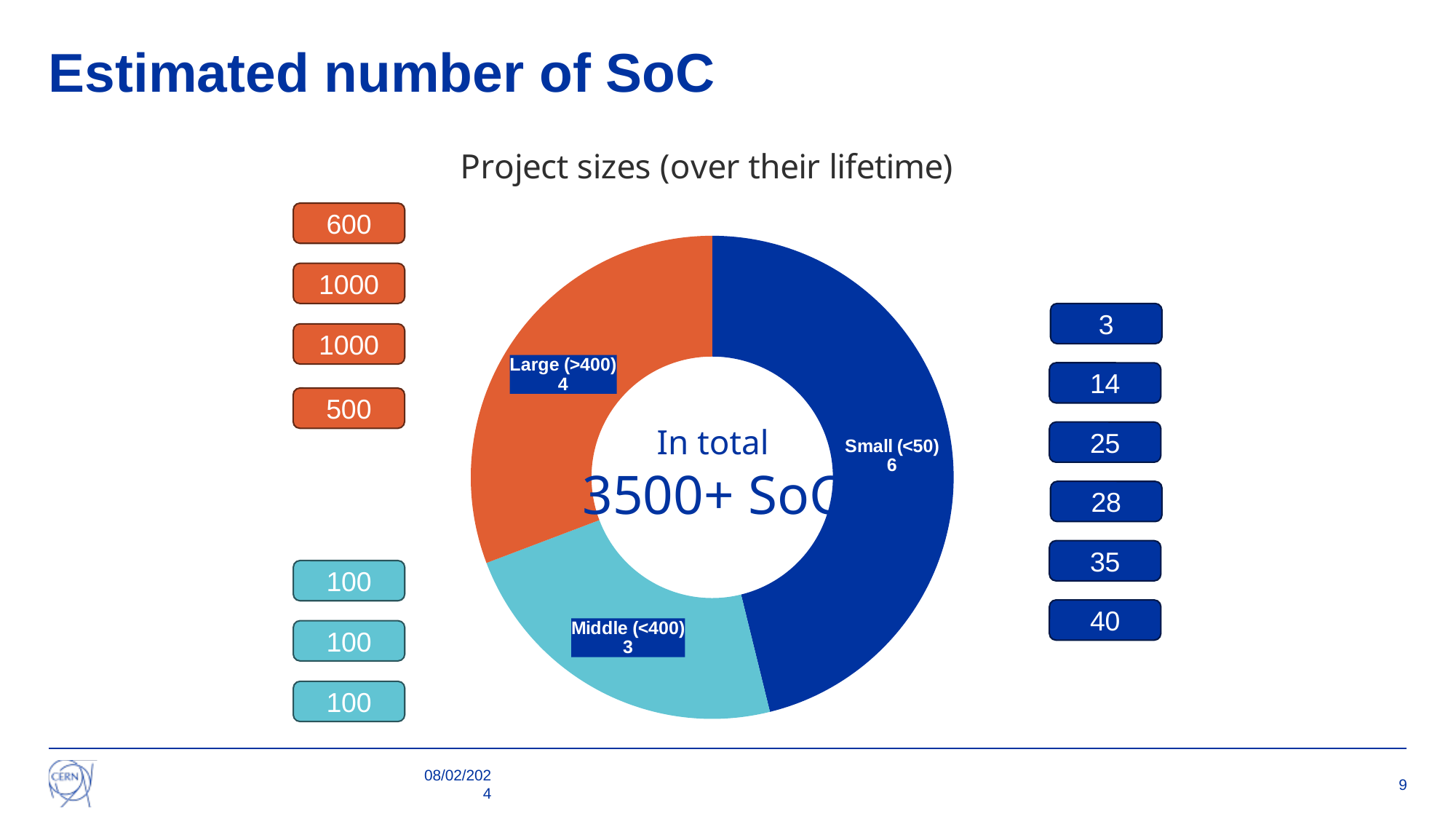
How many slices does the pie chart have? 3 What is the value shown for the Middle (<400) slice? 3 Which project size category has the smallest slice? Middle (<400) What is the title of the chart? Project sizes (over their lifetime) Which is larger, the value for Large (>400) or the value for Small (<50)? Small (<50) What total number of SoC is stated in the centre of the doughnut chart? 3500+ SoC What is the difference between the values for Small (<50) and Middle (<400)? 3 What is the difference between the values for Large (>400) and Middle (<400)? 1 What is the value shown for the Large (>400) slice? 4 What kind of chart is shown on the slide? Pie chart (doughnut) Which project size category has the largest slice? Small (<50) What is the value shown for the Small (<50) slice? 6